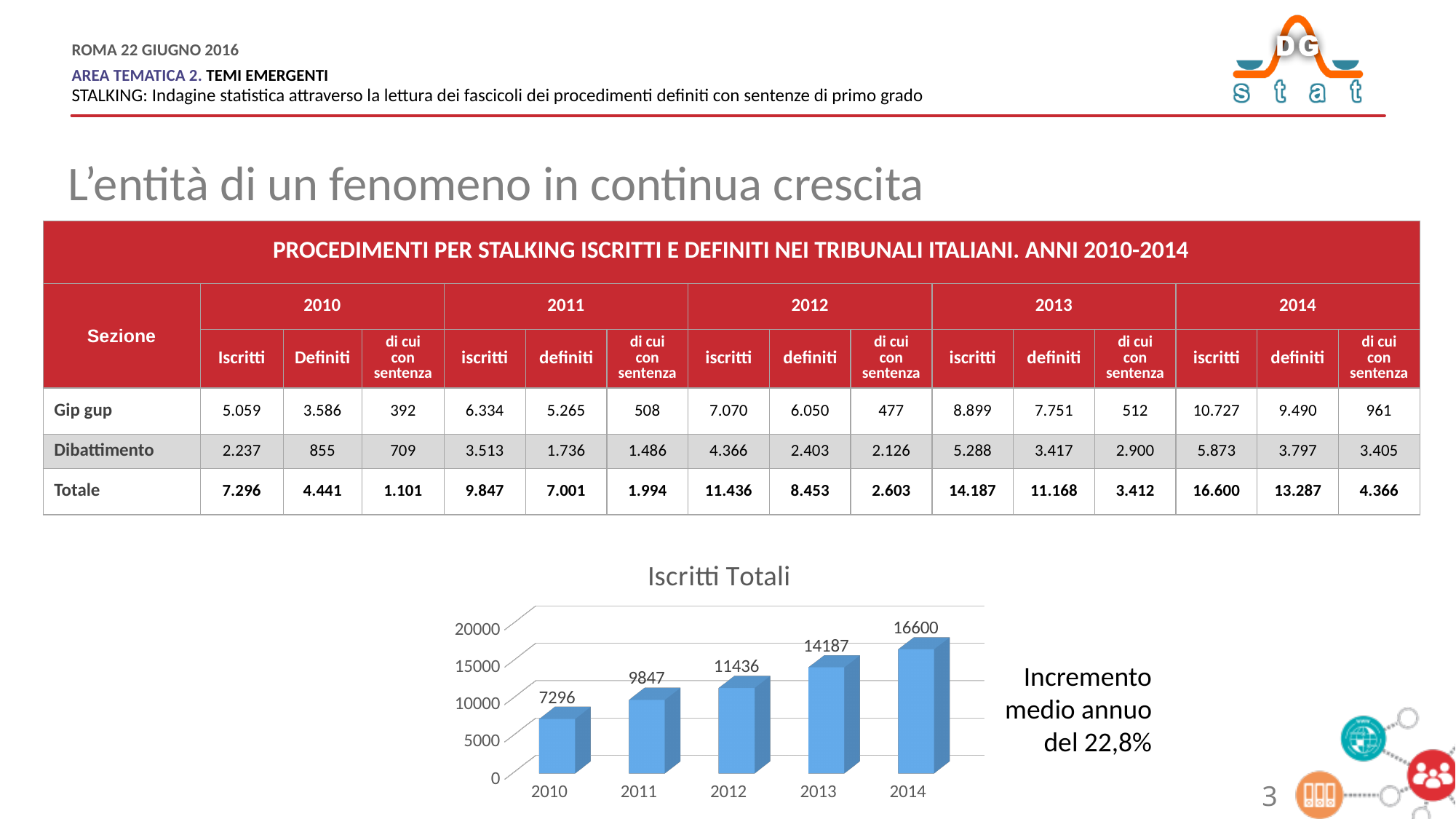
What kind of chart is the Iscritti Totali chart? bar chart Is the value for 2011 in the Iscritti Totali chart greater or less than 10000? less Which year has the lowest value in the Iscritti Totali chart? 2010 What is the difference between the 2013 and 2012 values in the Iscritti Totali chart? 2751 Do the values in the Iscritti Totali chart rise or fall from 2010 to 2014? rise What is the value for 2010 in the Iscritti Totali chart? 7296 What is the value for 2014 in the Iscritti Totali chart? 16600 Which is larger in the Iscritti Totali chart, the value for 2011 or the value for 2013? 2013 What is the difference between the 2014 and 2010 values in the Iscritti Totali chart? 9304 How many years are shown on the x axis of the Iscritti Totali chart? 5 Which year has the highest value in the Iscritti Totali chart? 2014 What is the value for 2012 in the Iscritti Totali chart? 11436